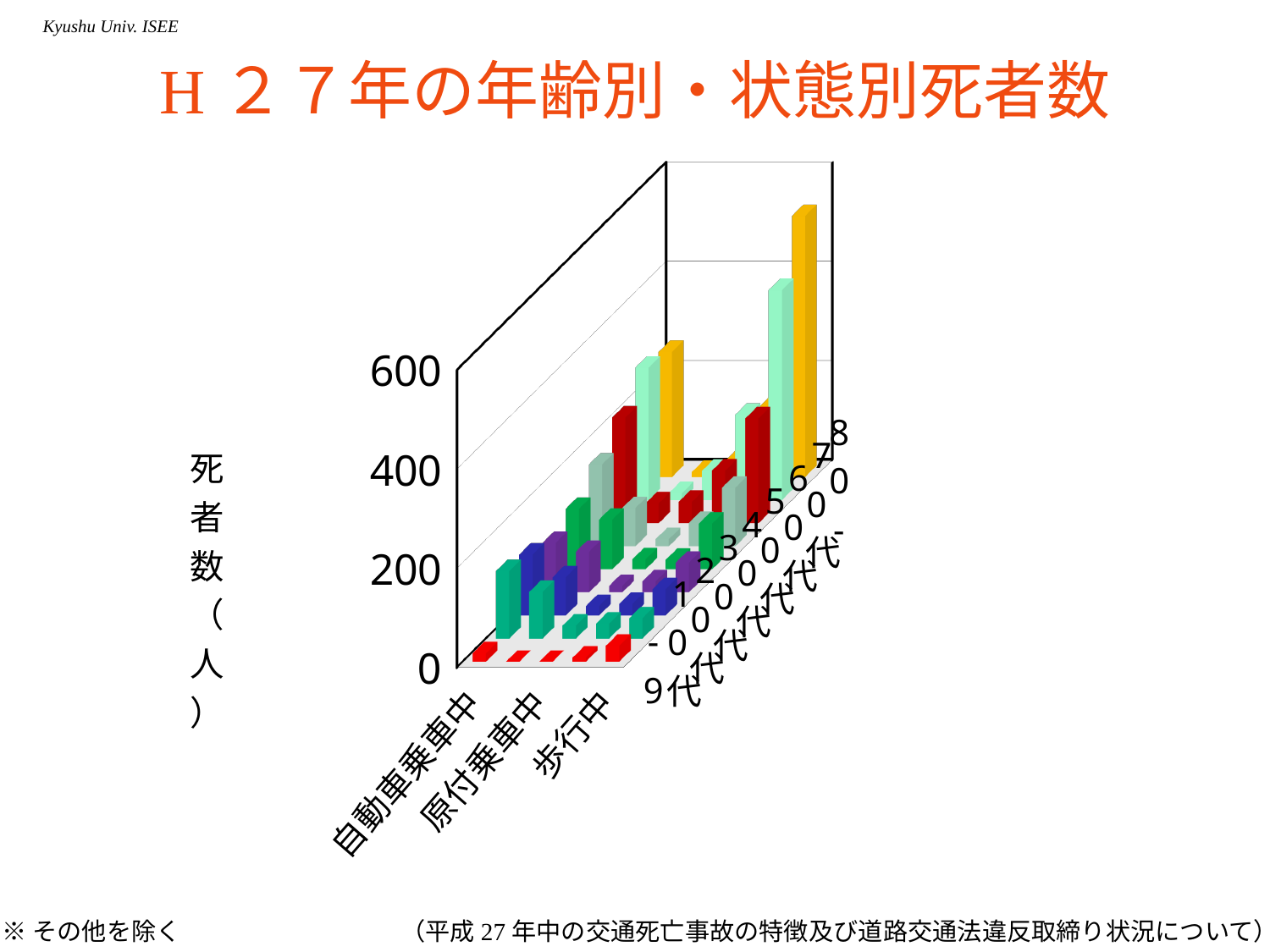
What kind of chart is shown on the slide? bar chart Is the value for 自動車乗車中 in the -9 age group greater or less than 200? less What is the title of the chart? H２７年の年齢別・状態別死者数 How many categories (states) are shown along the front axis of the chart? 5 For 歩行中, which age group has the highest number of deaths? 80- Which is larger: the value for 歩行中 in the 80代- age group or the value for 自動車乗車中 in the 80代- age group? 歩行中 in the 80代- age group Is the value for 歩行中 in the 80代- age group greater or less than 400? greater For 歩行中, do the values generally rise or fall as the age group increases? rise Which state category has the lowest values across the age groups? 原付乗車中 Which state category has the tallest bar in the chart? 歩行中 How many age groups are shown along the depth axis of the chart? 9 What is the label on the vertical axis of the chart? 死者数（人）